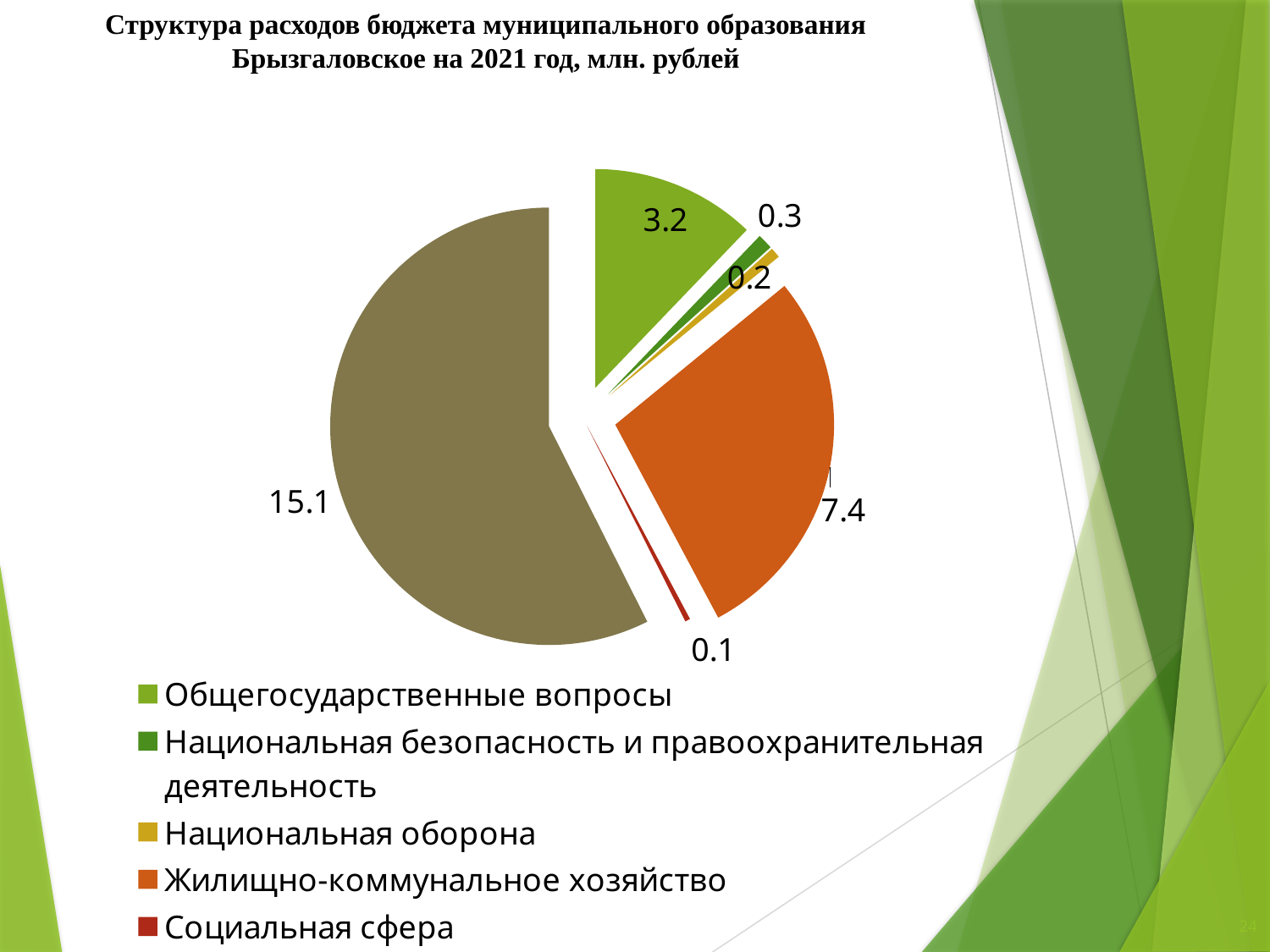
Which category has the smallest value in the pie chart? Социальная сфера Which is larger: Национальная безопасность и правоохранительная деятельность or Национальная оборона? Национальная безопасность и правоохранительная деятельность How many entries does the legend list? 5 What is the value for Социальная сфера? 0.1 What is the value for Национальная оборона? 0.2 What is the value for Общегосударственные вопросы? 3.2 How many slices does the pie chart have? 6 What is the value of the largest slice in the pie chart? 15.1 What is the difference between the values for Жилищно-коммунальное хозяйство and Общегосударственные вопросы? 4.2 What is the value for Национальная безопасность и правоохранительная деятельность? 0.3 What is the value for Жилищно-коммунальное хозяйство? 7.4 What kind of chart is shown on the slide? pie chart